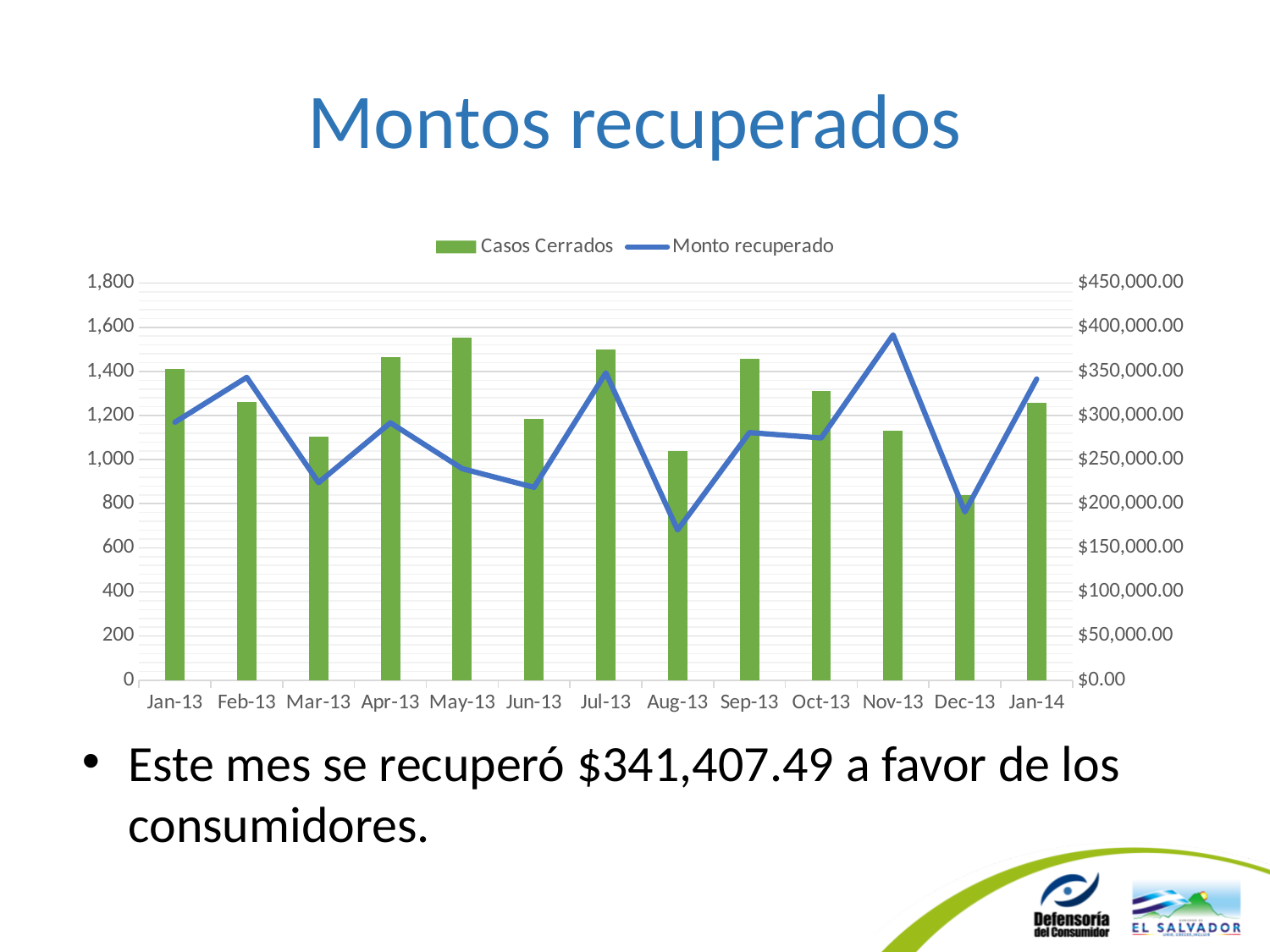
In which month does the Monto recuperado line reach its lowest point? Aug-13 Which month has the lowest Casos Cerrados bar? Dec-13 What kind of chart is shown on the slide? A combined bar and line chart In which month does the Monto recuperado line reach its highest point? Nov-13 Is the Monto recuperado value for Nov-13 greater or less than $350,000.00? greater Does the Monto recuperado line rise or fall from Nov-13 to Dec-13? Fall Is the Casos Cerrados value for Dec-13 greater or less than 1,000? less How many series does the legend list? 2 How many months are shown along the x axis? 13 What is the title of the chart? Montos recuperados Which month has more Casos Cerrados, Jan-13 or Feb-13? Jan-13 Which month has the highest Casos Cerrados bar? May-13